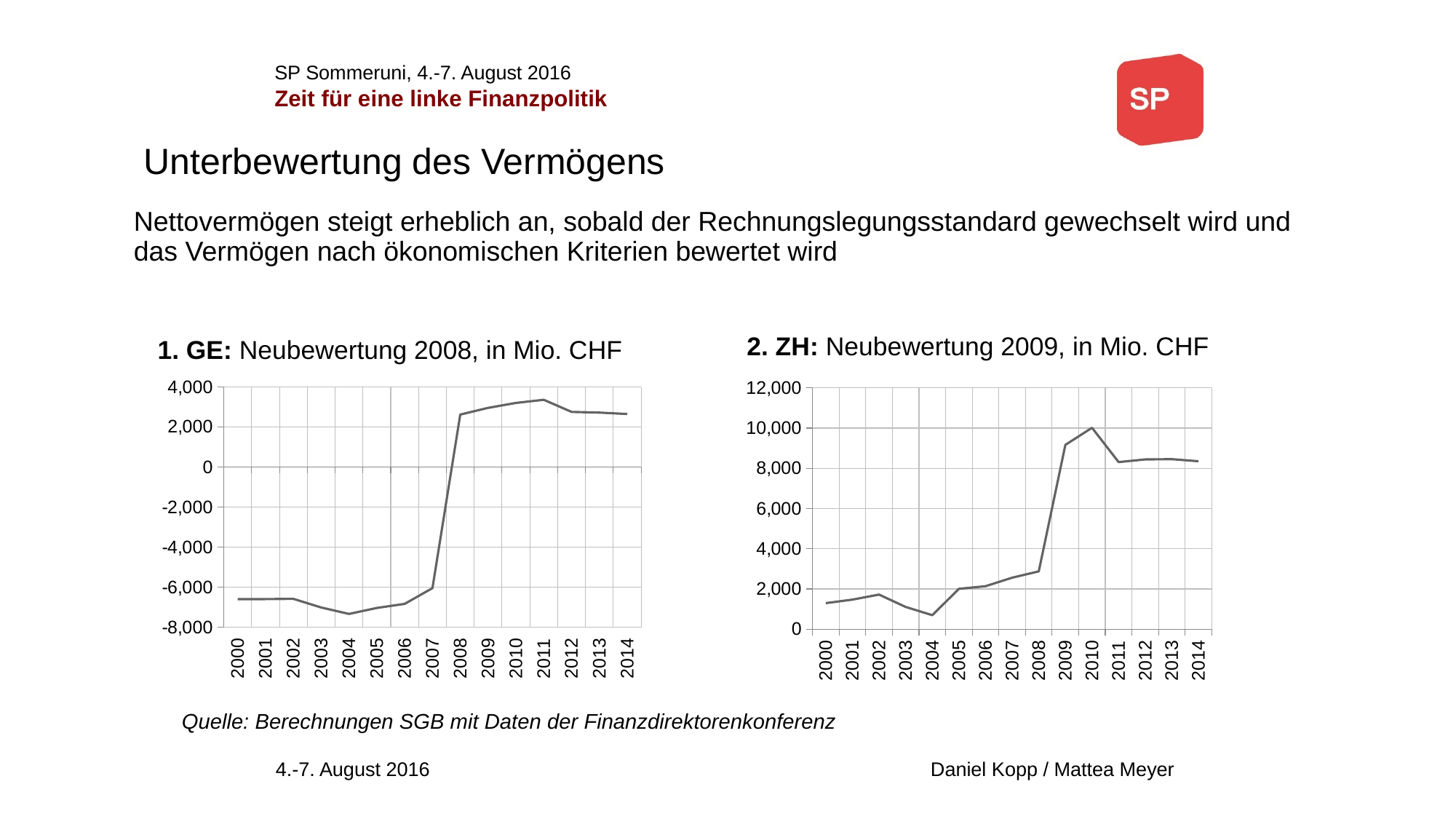
In the '2. ZH: Neubewertung 2009, in Mio. CHF' chart, which year has the highest value? 2010 In the '1. GE: Neubewertung 2008, in Mio. CHF' chart, does the value rise or fall between 2007 and 2008? rise What kind of chart is the '1. GE: Neubewertung 2008, in Mio. CHF' chart? line chart In the '2. ZH: Neubewertung 2009, in Mio. CHF' chart, which year has the lowest value? 2004 In the '1. GE: Neubewertung 2008, in Mio. CHF' chart, which year has the lowest value? 2004 In the '1. GE: Neubewertung 2008, in Mio. CHF' chart, is the value for 2004 greater or less than -6,000? less In the '2. ZH: Neubewertung 2009, in Mio. CHF' chart, is the value for 2010 greater or less than 8,000? greater In the '1. GE: Neubewertung 2008, in Mio. CHF' chart, which year has the highest value? 2011 In the '2. ZH: Neubewertung 2009, in Mio. CHF' chart, which year has the larger value, 2009 or 2011? 2009 In the '2. ZH: Neubewertung 2009, in Mio. CHF' chart, is the value for 2004 greater or less than 2,000? less How many years are plotted on the x axis of the '2. ZH: Neubewertung 2009, in Mio. CHF' chart? 15